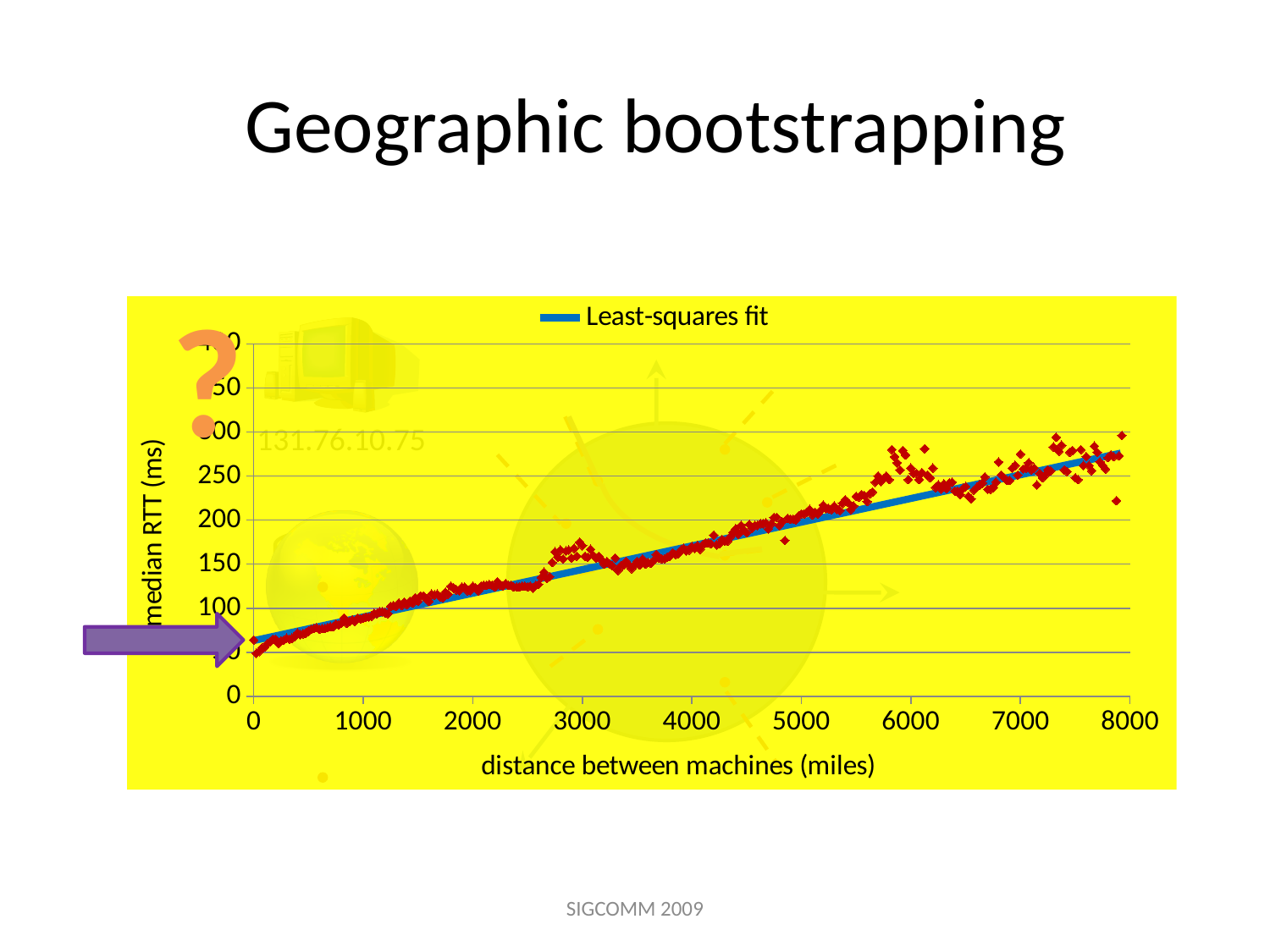
What is the title of the y axis? median RTT (ms) Is the median RTT at a distance of 2000 miles greater or less than 100? greater Is the median RTT at a distance of 4000 miles greater or less than 200? less What kind of chart is shown on the slide? scatter chart Is the median RTT at a distance of 7000 miles greater or less than 200? greater What entry does the legend show? Least-squares fit What is the title of the x axis? distance between machines (miles) Does median RTT rise or fall as the distance between machines increases? rise What is the largest value shown on the x axis? 8000